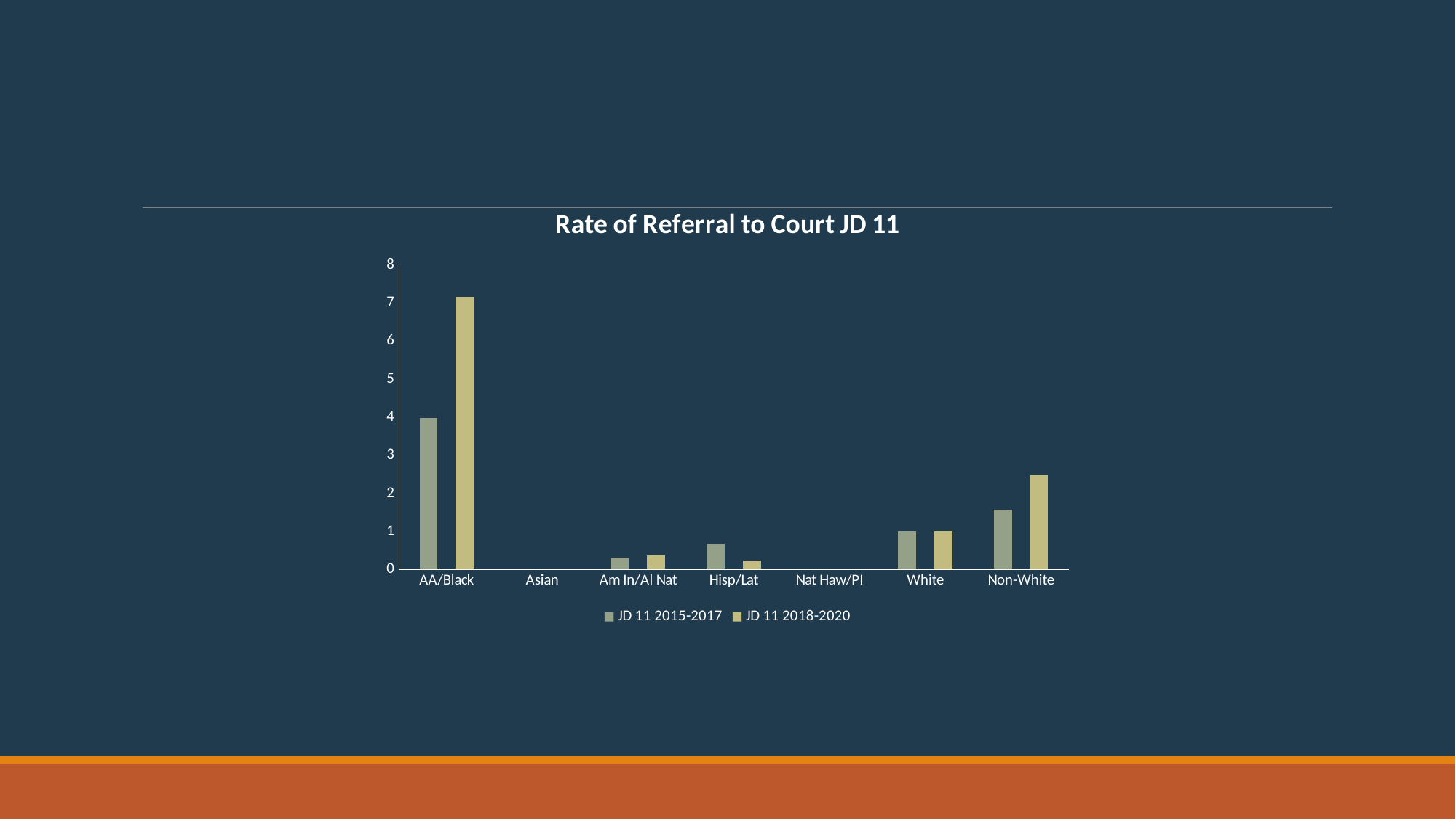
Which category has the highest value for JD 11 2015-2017? AA/Black Which category has the highest value for JD 11 2018-2020? AA/Black Is the JD 11 2018-2020 value for AA/Black greater or less than 7? greater What is the title of the chart? Rate of Referral to Court JD 11 For Hisp/Lat, which series has the larger value, JD 11 2015-2017 or JD 11 2018-2020? JD 11 2015-2017 What kind of chart is shown on the slide? bar chart Is the JD 11 2018-2020 value for Non-White greater or less than 2? greater How many series does the legend list? 2 For Non-White, which series has the larger value, JD 11 2015-2017 or JD 11 2018-2020? JD 11 2018-2020 How many categories are shown on the x axis? 7 Which series is shown in the lighter tan colour? JD 11 2018-2020